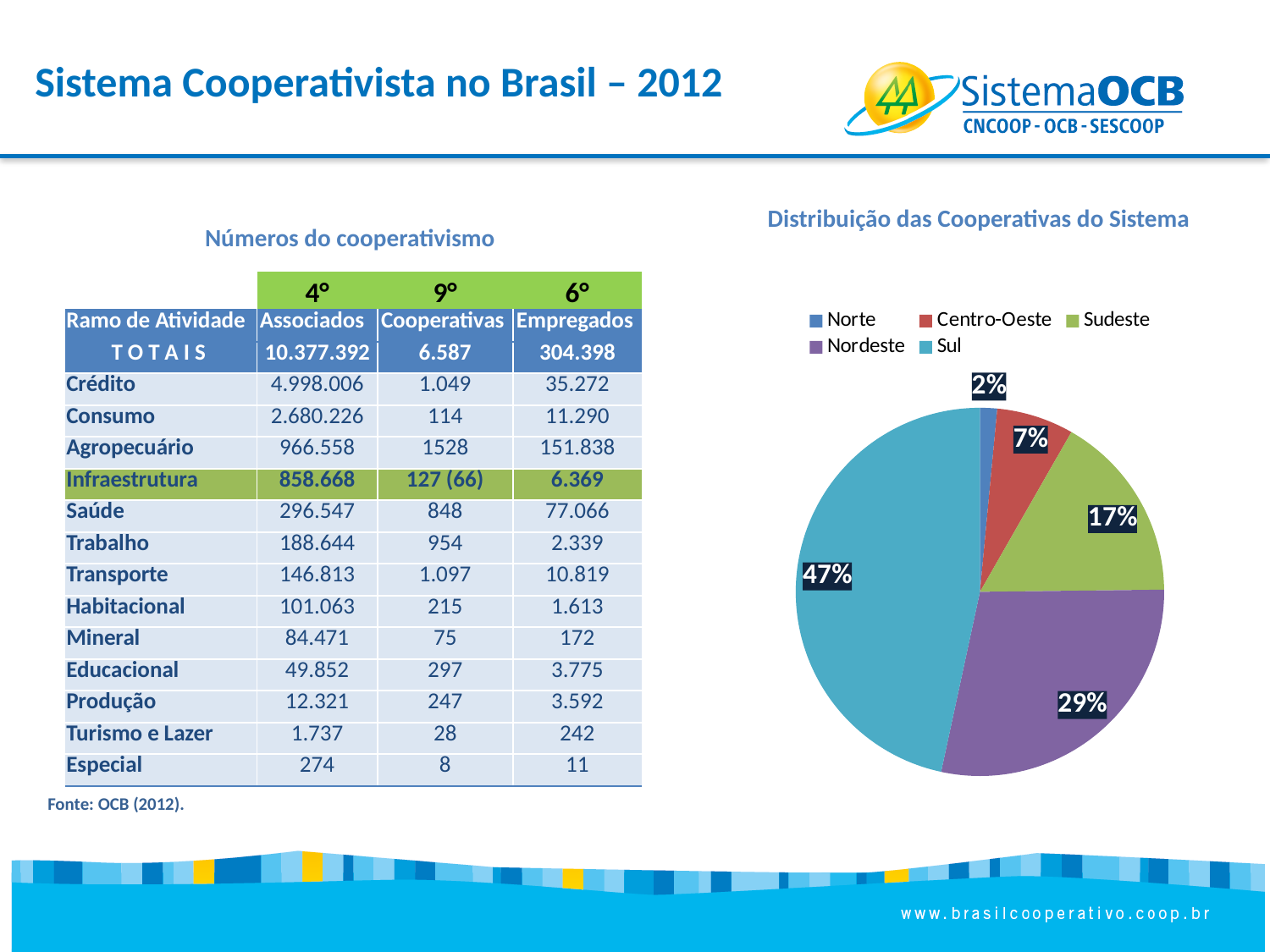
Which region has the smallest slice in the pie chart? Norte In the pie chart, what share of cooperatives is in the Sudeste region? 17% In the pie chart, which slice is larger: Sudeste or Centro-Oeste? Sudeste How many regions does the legend of the pie chart list? 5 In the pie chart, what share of cooperatives is in the Centro-Oeste region? 7% What is the title of the pie chart on the slide? Distribuição das Cooperativas do Sistema In the pie chart, what share of cooperatives is in the Norte region? 2% Which region has the largest slice in the pie chart? Sul In the pie chart, what share of cooperatives is in the Sul region? 47% What kind of chart is shown under the title "Distribuição das Cooperativas do Sistema"? pie chart In the pie chart, what share of cooperatives is in the Nordeste region? 29% In the pie chart, what is the difference in percentage points between the Sul and Nordeste slices? 18